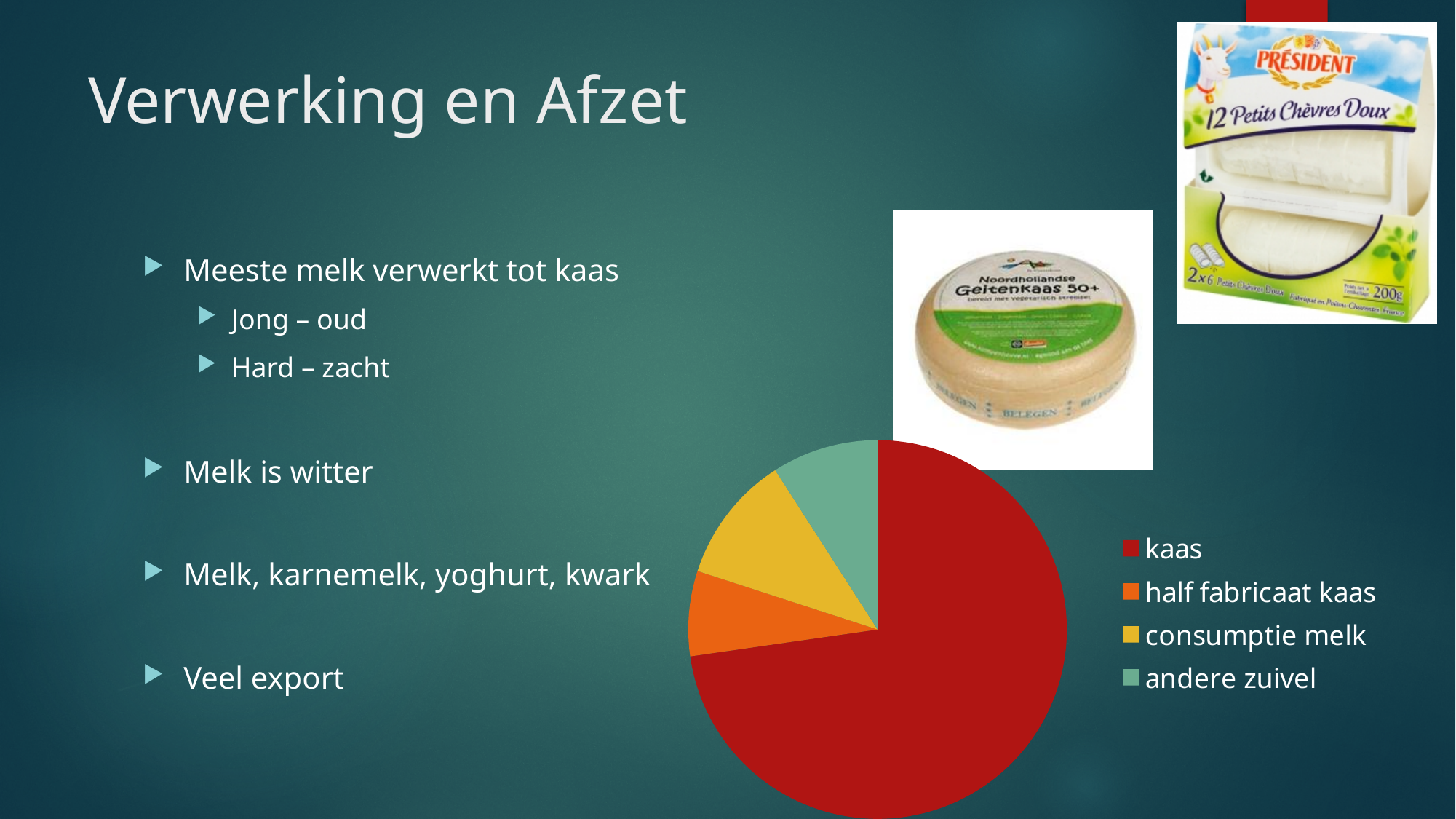
Which slice is larger in the pie chart, consumptie melk or half fabricaat kaas? consumptie melk How many entries does the legend of the pie chart list? 4 Which slice is larger in the pie chart, kaas or consumptie melk? kaas Which category has the smallest slice in the pie chart? half fabricaat kaas How many slices does the pie chart have? 4 Is the share of kaas in the pie chart greater or less than half of the pie? greater Which slice is larger in the pie chart, consumptie melk or andere zuivel? consumptie melk Which legend entry is shown in yellow in the pie chart? consumptie melk What kind of chart is shown on the slide? pie chart What colour is the kaas slice in the pie chart? red Which category has the largest slice in the pie chart? kaas